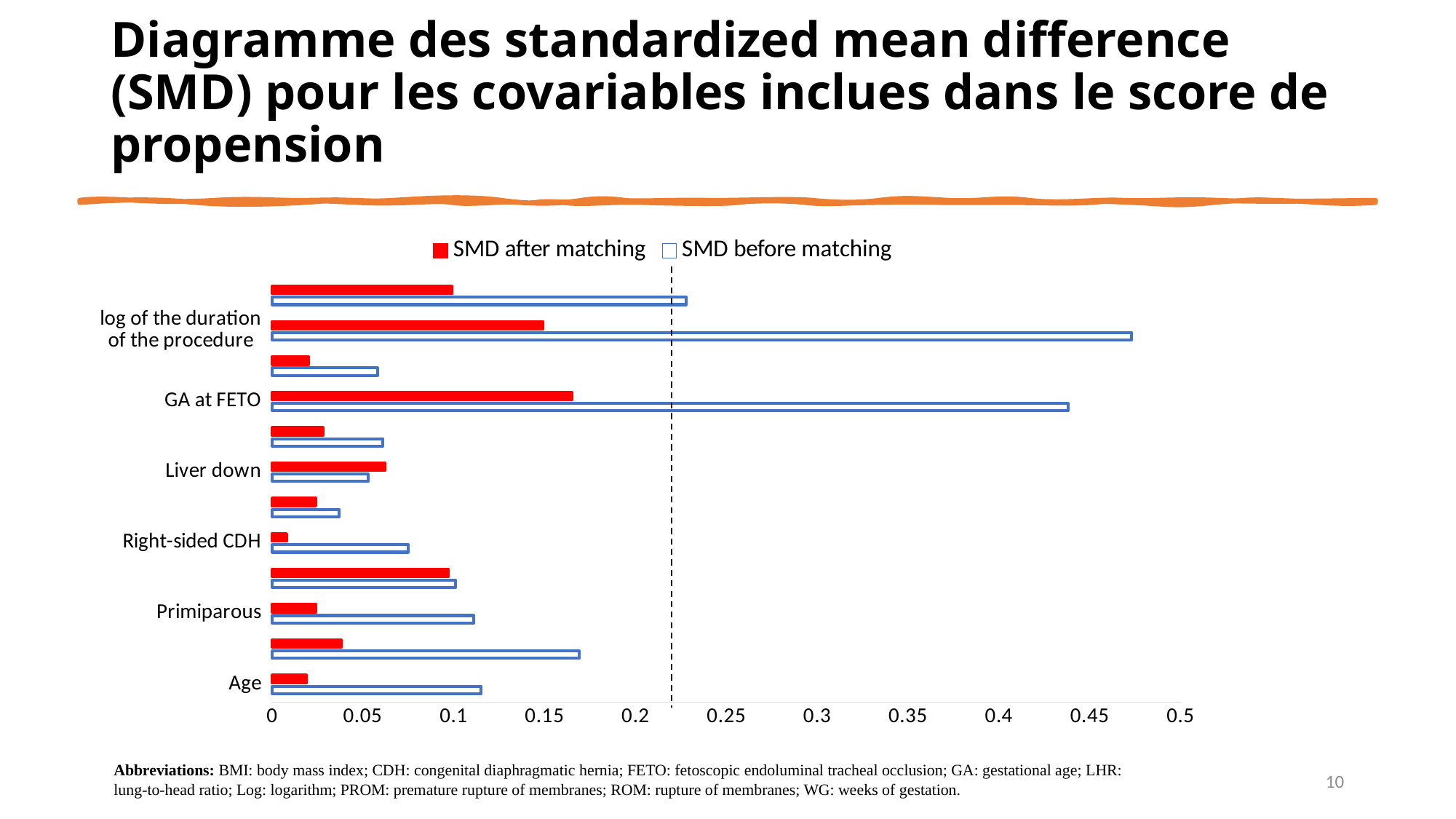
Is the SMD after matching value for Age greater or less than 0.05? less Is the SMD before matching value for Primiparous greater or less than 0.15? less For GA at FETO, which is larger: the SMD before matching or the SMD after matching? SMD before matching Is the SMD after matching value for log of the duration of the procedure greater or less than 0.1? greater What kind of chart is shown on the slide? bar chart How many series does the chart legend list? 2 Which colour represents the SMD after matching series? red Among the labelled categories, which has the highest SMD before matching? log of the duration of the procedure What are the two series named in the chart legend? SMD after matching; SMD before matching